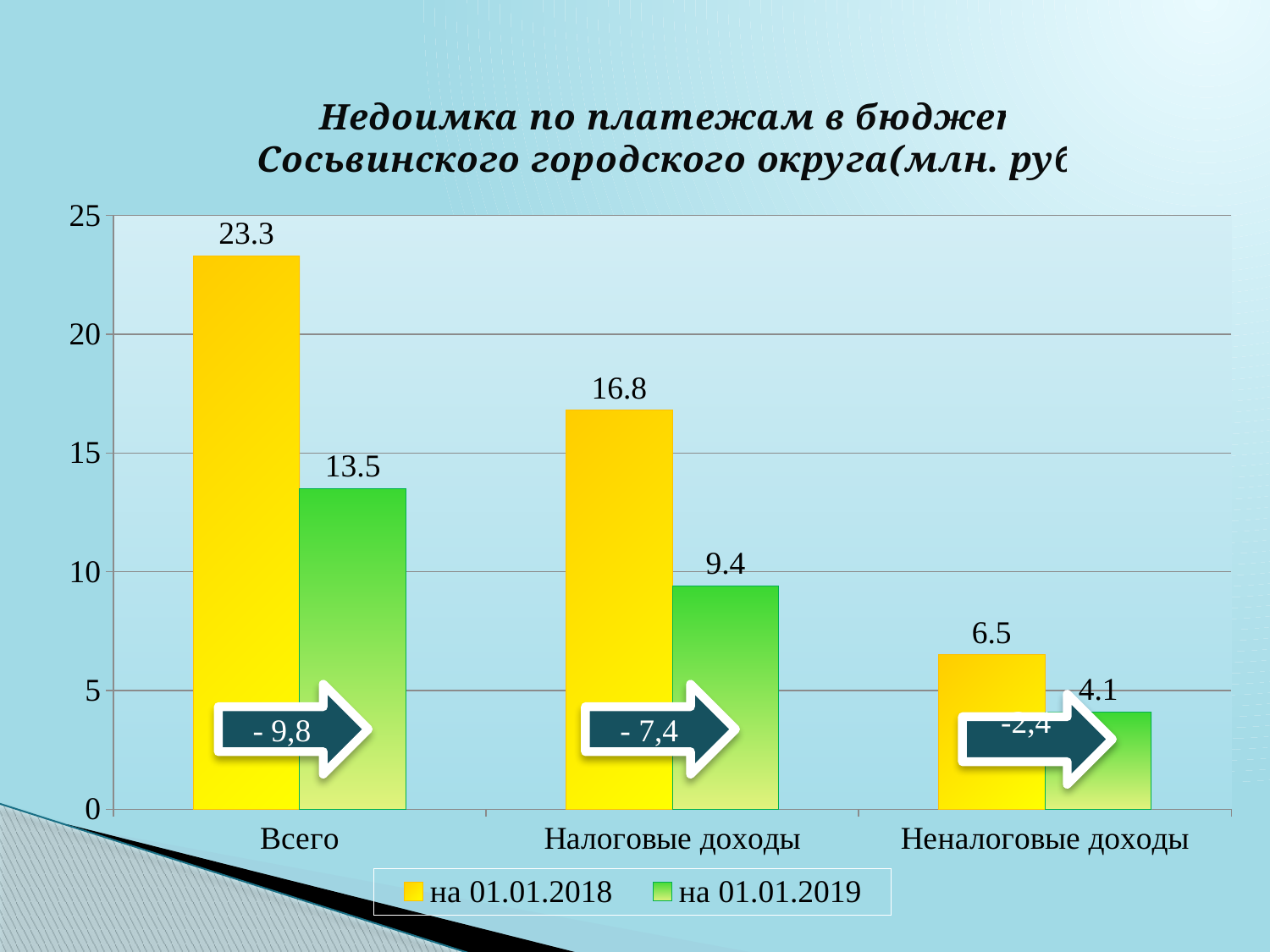
How many series does the legend list? 2 Which category has the highest value for на 01.01.2019? Всего What is the value for Всего on 01.01.2018? 23.3 Which colour represents the series на 01.01.2019? green What is the value for Неналоговые доходы on 01.01.2018? 6.5 What is the value for Неналоговые доходы on 01.01.2019? 4.1 What is the value for Налоговые доходы on 01.01.2019? 9.4 Which category has the lowest value for на 01.01.2018? Неналоговые доходы What kind of chart is shown on the slide? bar chart What is the difference between the 01.01.2018 and 01.01.2019 values for Налоговые доходы? 7.4 Which is larger: the 01.01.2019 value for Всего or the 01.01.2018 value for Налоговые доходы? на 01.01.2018 value for Налоговые доходы How many categories are shown on the x axis? 3